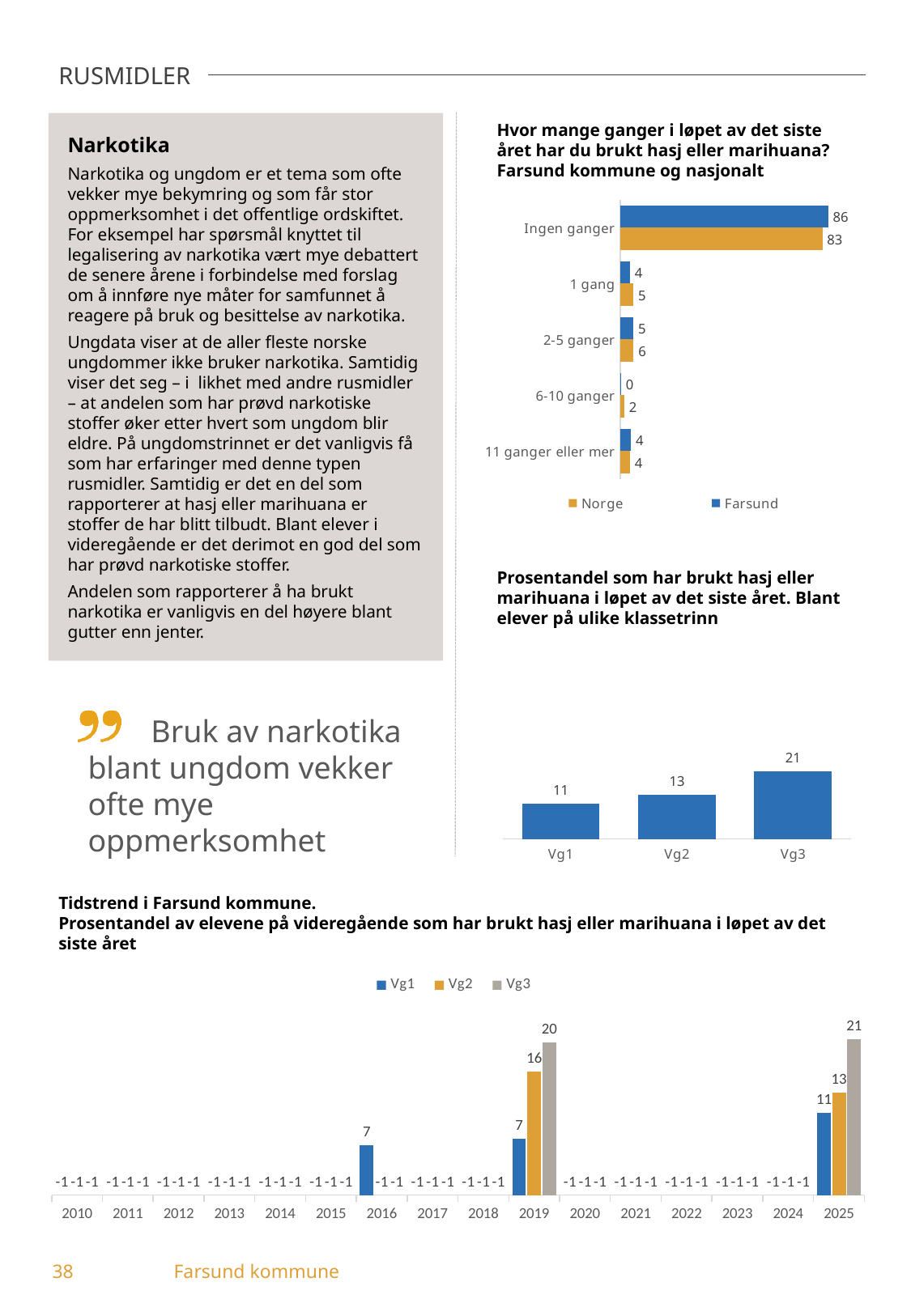
In the chart 'Prosentandel som har brukt hasj eller marihuana i løpet av det siste året. Blant elever på ulike klassetrinn', what is the value for Vg2? 13 In the chart 'Hvor mange ganger i løpet av det siste året har du brukt hasj eller marihuana?', what is the value for Norge in the category '6-10 ganger'? 2 In the chart 'Hvor mange ganger i løpet av det siste året har du brukt hasj eller marihuana?', how many series does the legend list? 2 In the chart 'Tidstrend i Farsund kommune', what is the value for Vg3 in 2019? 20 In the chart 'Hvor mange ganger i løpet av det siste året har du brukt hasj eller marihuana?', what is the value for Farsund in the category 'Ingen ganger'? 86 In the chart 'Tidstrend i Farsund kommune', what is the value for Vg1 in 2016? 7 In the chart 'Prosentandel som har brukt hasj eller marihuana i løpet av det siste året. Blant elever på ulike klassetrinn', which class level has the highest value? Vg3 In the chart 'Tidstrend i Farsund kommune', which is larger in 2025: Vg2 or Vg3? Vg3 In the chart 'Hvor mange ganger i løpet av det siste året har du brukt hasj eller marihuana?', what is the difference between Farsund and Norge for 'Ingen ganger'? 3 What kind of chart is the 'Tidstrend i Farsund kommune' chart at the bottom of the slide? bar chart In the chart 'Hvor mange ganger i løpet av det siste året har du brukt hasj eller marihuana?', how many categories are shown? 5 In the chart 'Prosentandel som har brukt hasj eller marihuana i løpet av det siste året. Blant elever på ulike klassetrinn', do the values rise or fall from Vg1 to Vg3? rise